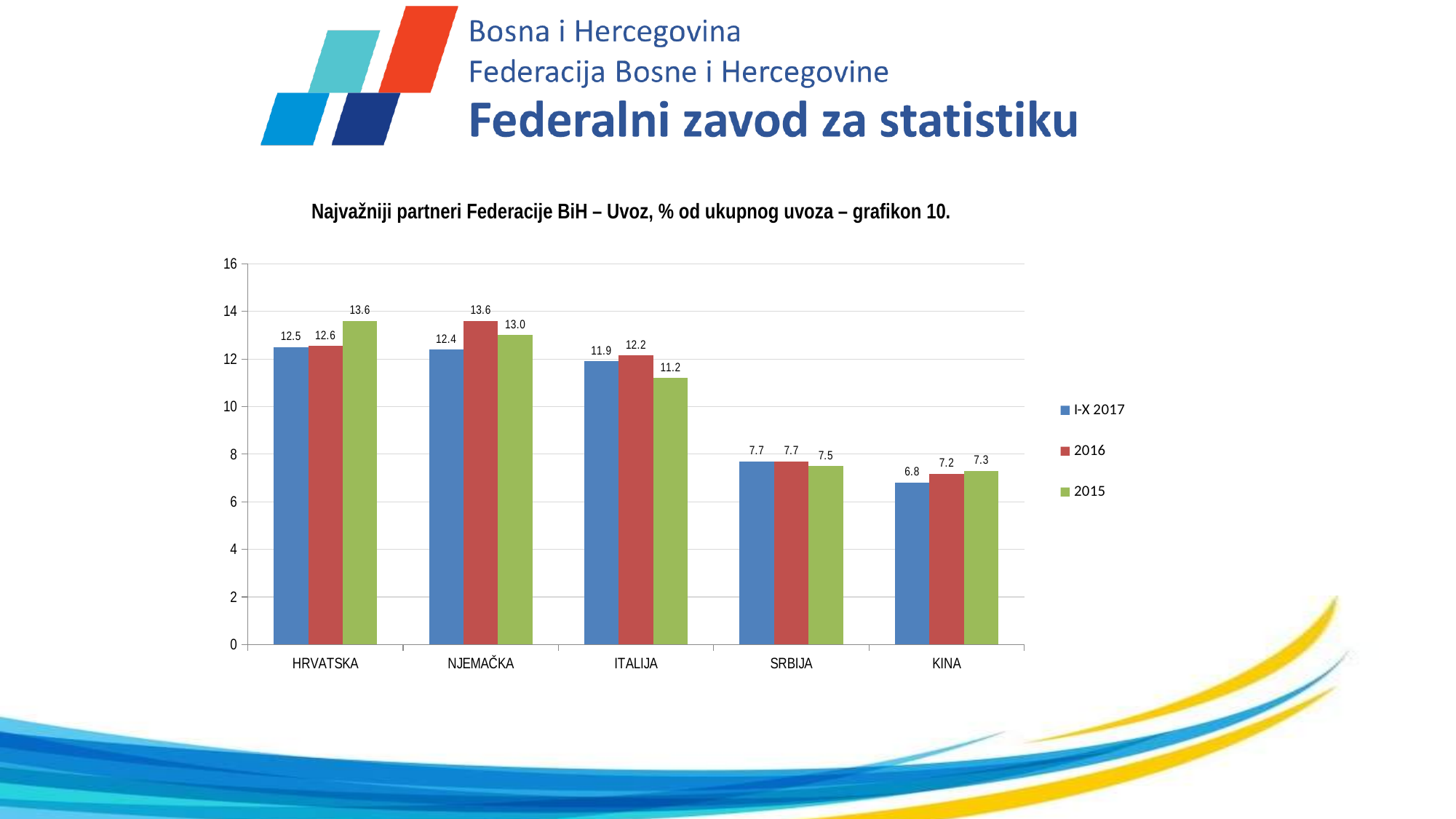
What is the value for ITALIJA in the 2016 series? 12.2 What is the value for KINA in the I-X 2017 series? 6.8 How many series does the legend list? 3 What is the difference between the 2016 and 2015 values for NJEMAČKA? 0.6 Which category has the highest value in the 2016 series? NJEMAČKA Which is larger for ITALIJA: the I-X 2017 value or the 2015 value? I-X 2017 What is the value for HRVATSKA in the 2015 series? 13.6 What kind of chart is shown on the slide? bar chart Is the value for SRBIJA in the 2015 series greater or less than 8? less How many categories are shown on the x axis? 5 What colour represents the 2016 series in the legend? red Which category has the lowest value in the I-X 2017 series? KINA